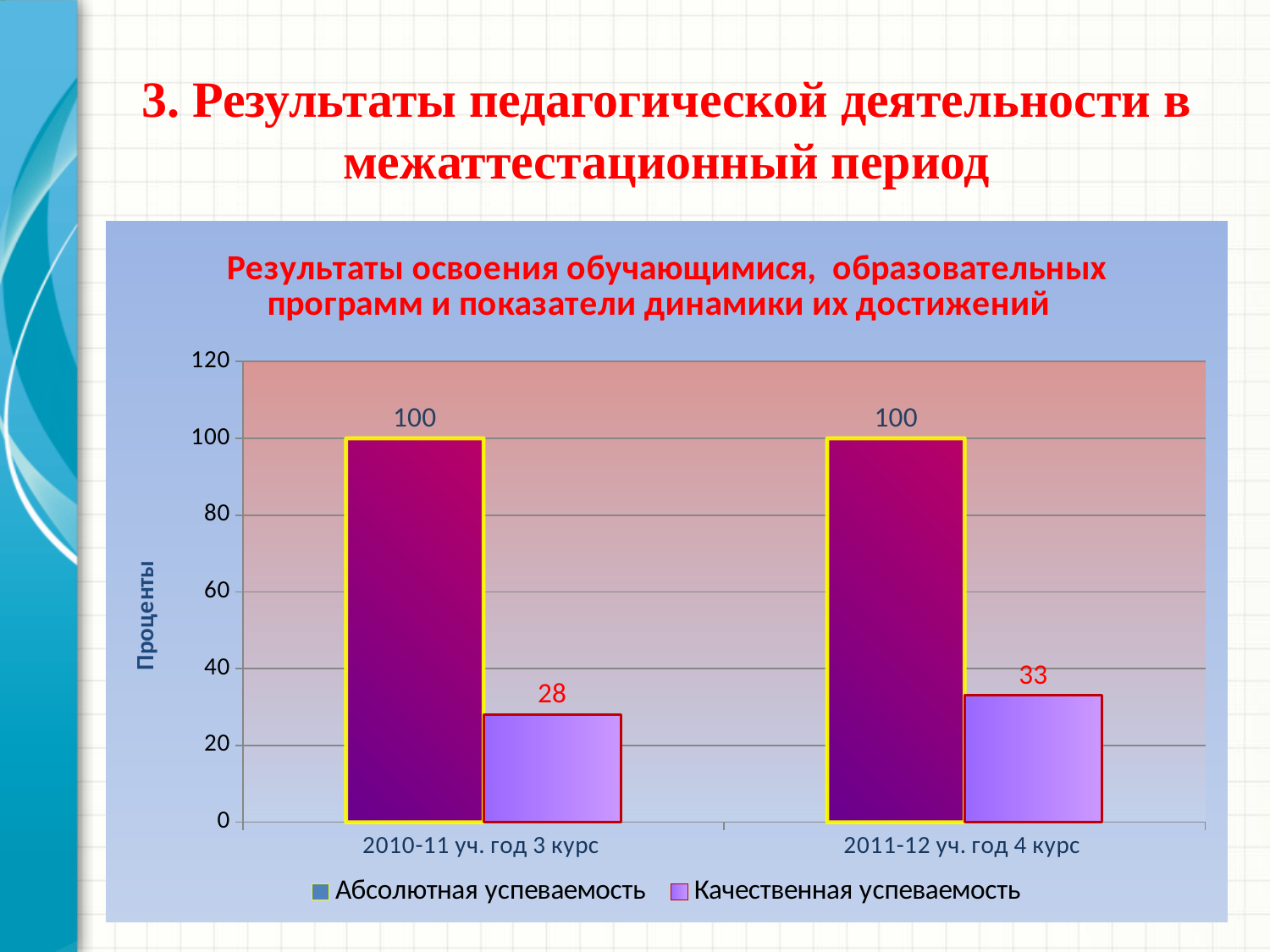
What is the difference between Качественная успеваемость in 2011-12 уч. год 4 курс and in 2010-11 уч. год 3 курс? 5 What is the value of Качественная успеваемость for 2011-12 уч. год 4 курс? 33 Which is larger for 2011-12 уч. год 4 курс: Абсолютная успеваемость or Качественная успеваемость? Абсолютная успеваемость Does Качественная успеваемость rise or fall from 2010-11 уч. год 3 курс to 2011-12 уч. год 4 курс? rise What kind of chart is shown? bar chart What is the difference between Абсолютная успеваемость and Качественная успеваемость for 2010-11 уч. год 3 курс? 72 How many series does the legend list? 2 Which category has the higher value for Качественная успеваемость? 2011-12 уч. год 4 курс How many categories are shown on the x axis? 2 What is the value of Абсолютная успеваемость for 2011-12 уч. год 4 курс? 100 What is the label of the vertical axis? Проценты What is the value of Качественная успеваемость for 2010-11 уч. год 3 курс? 28